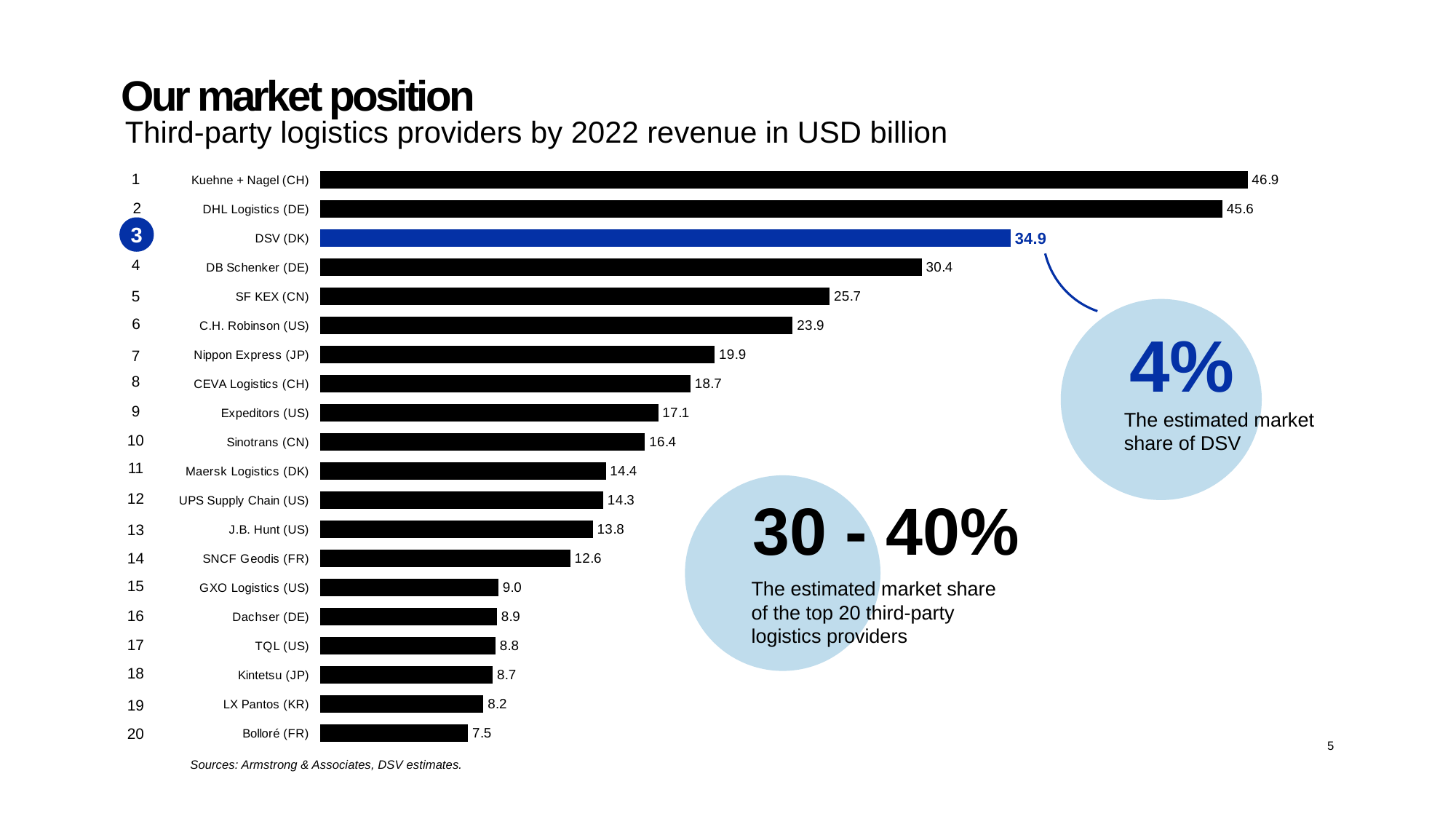
What is the difference in 2022 revenue between DSV (DK) and DB Schenker (DE)? 4.5 What is the 2022 revenue shown for Bolloré (FR)? 7.5 Which third-party logistics provider has the lowest 2022 revenue on the chart? Bolloré (FR) Which third-party logistics provider has the highest 2022 revenue on the chart? Kuehne + Nagel (CH) What is the 2022 revenue shown for DSV (DK)? 34.9 Which has the larger 2022 revenue, SF KEX (CN) or C.H. Robinson (US)? SF KEX (CN) Which provider's bar is highlighted in blue on the chart? DSV (DK) What kind of chart is used to show the 2022 revenue of third-party logistics providers? Bar chart Which has the larger 2022 revenue, Expeditors (US) or Sinotrans (CN)? Expeditors (US) What is the 2022 revenue shown for Nippon Express (JP)? 19.9 How many third-party logistics providers are listed on the chart? 20 What is the difference in 2022 revenue between Kuehne + Nagel (CH) and DHL Logistics (DE)? 1.3